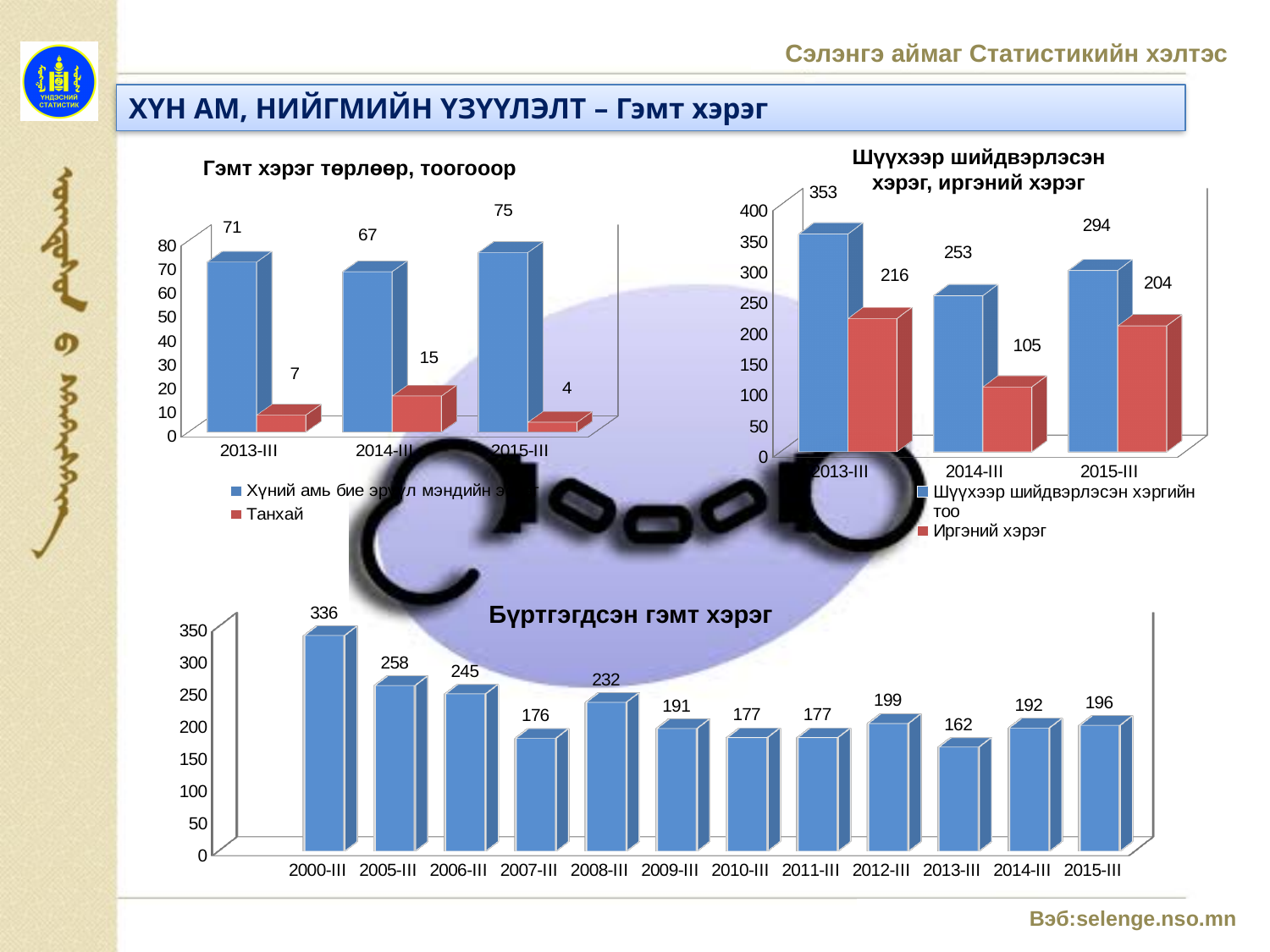
In the chart 'Шүүхээр шийдвэрлэсэн хэрэг, иргэний хэрэг', what is the value of 'Иргэний хэрэг' for 2014-III? 105 In the chart 'Бүртгэгдсэн гэмт хэрэг', how many categories are shown on the x axis? 12 In the chart 'Гэмт хэрэг төрлөөр, тоогооор', is the value of the blue series for 2015-III larger or smaller than for 2014-III? Larger In the chart 'Бүртгэгдсэн гэмт хэрэг', what kind of chart is it? Bar chart In the chart 'Гэмт хэрэг төрлөөр, тоогооор', which category has the lowest value for 'Танхай'? 2015-III In the chart 'Шүүхээр шийдвэрлэсэн хэрэг, иргэний хэрэг', which category has the highest value for 'Шүүхээр шийдвэрлэсэн хэргийн тоо'? 2013-III In the chart 'Гэмт хэрэг төрлөөр, тоогооор', what is the value of 'Танхай' for 2014-III? 15 In the chart 'Шүүхээр шийдвэрлэсэн хэрэг, иргэний хэрэг', how many series does the legend list? 2 In the chart 'Бүртгэгдсэн гэмт хэрэг', what is the value for 2000-III? 336 In the chart 'Шүүхээр шийдвэрлэсэн хэрэг, иргэний хэрэг', what is the difference between the two series' values for 2015-III? 90 In the chart 'Бүртгэгдсэн гэмт хэрэг', what is the difference between the values for 2000-III and 2005-III? 78 In the chart 'Бүртгэгдсэн гэмт хэрэг', which category has the lowest value? 2013-III